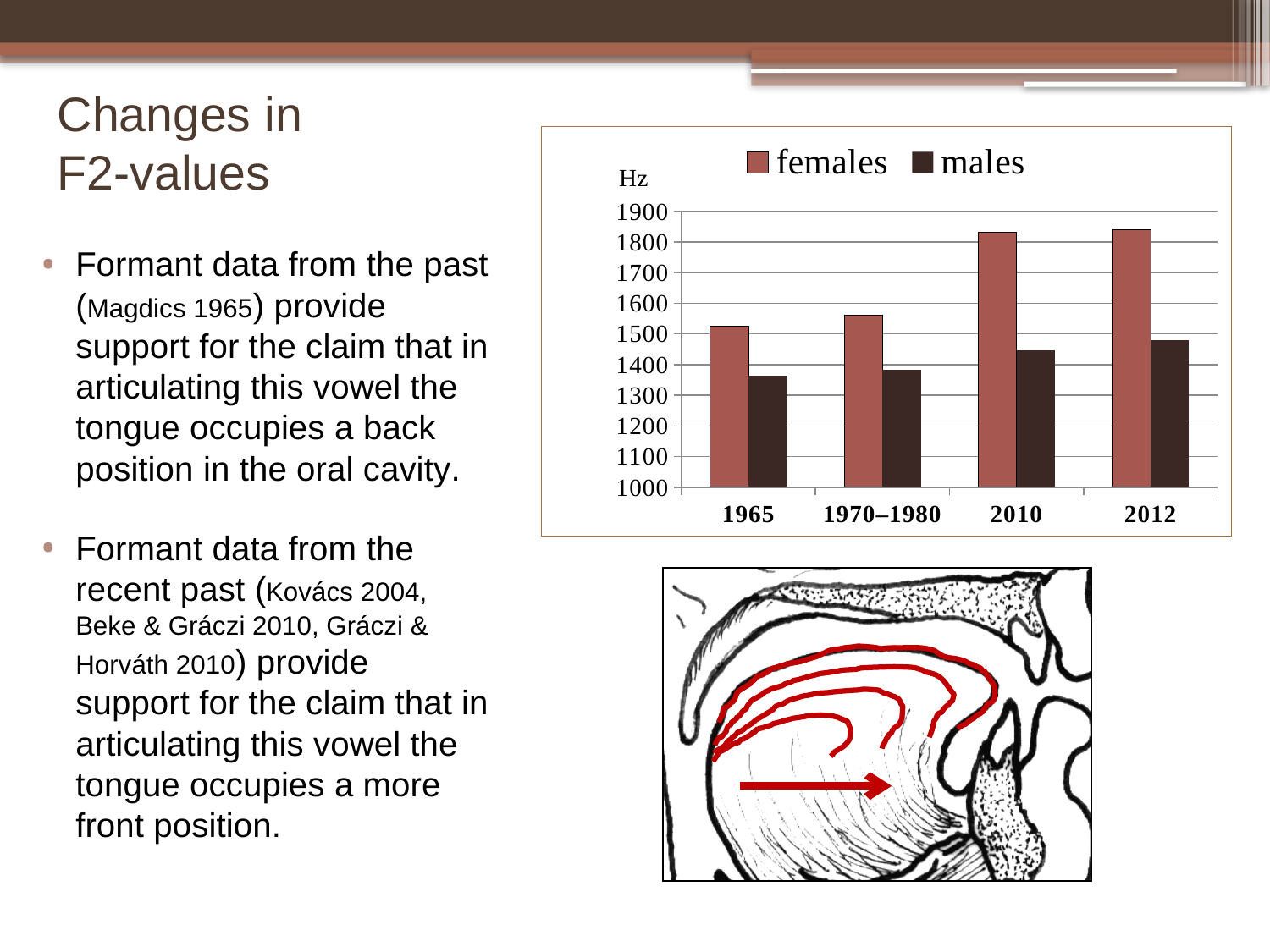
Is the value for females in 2010 greater or less than 1800? greater Do the values for females rise or fall from 1965 to 2012? rise Is the value for males in 1965 greater or less than 1400? less Is the value for females in 1970–1980 greater or less than 1600? less Which is larger in 2010, the value for females or the value for males? females What unit is shown on the y axis of the chart? Hz How many series does the chart's legend list? 2 What kind of chart is shown on the slide? bar chart How many time periods are shown on the x axis of the chart? 4 Which is larger in 1965, the value for females or the value for males? females